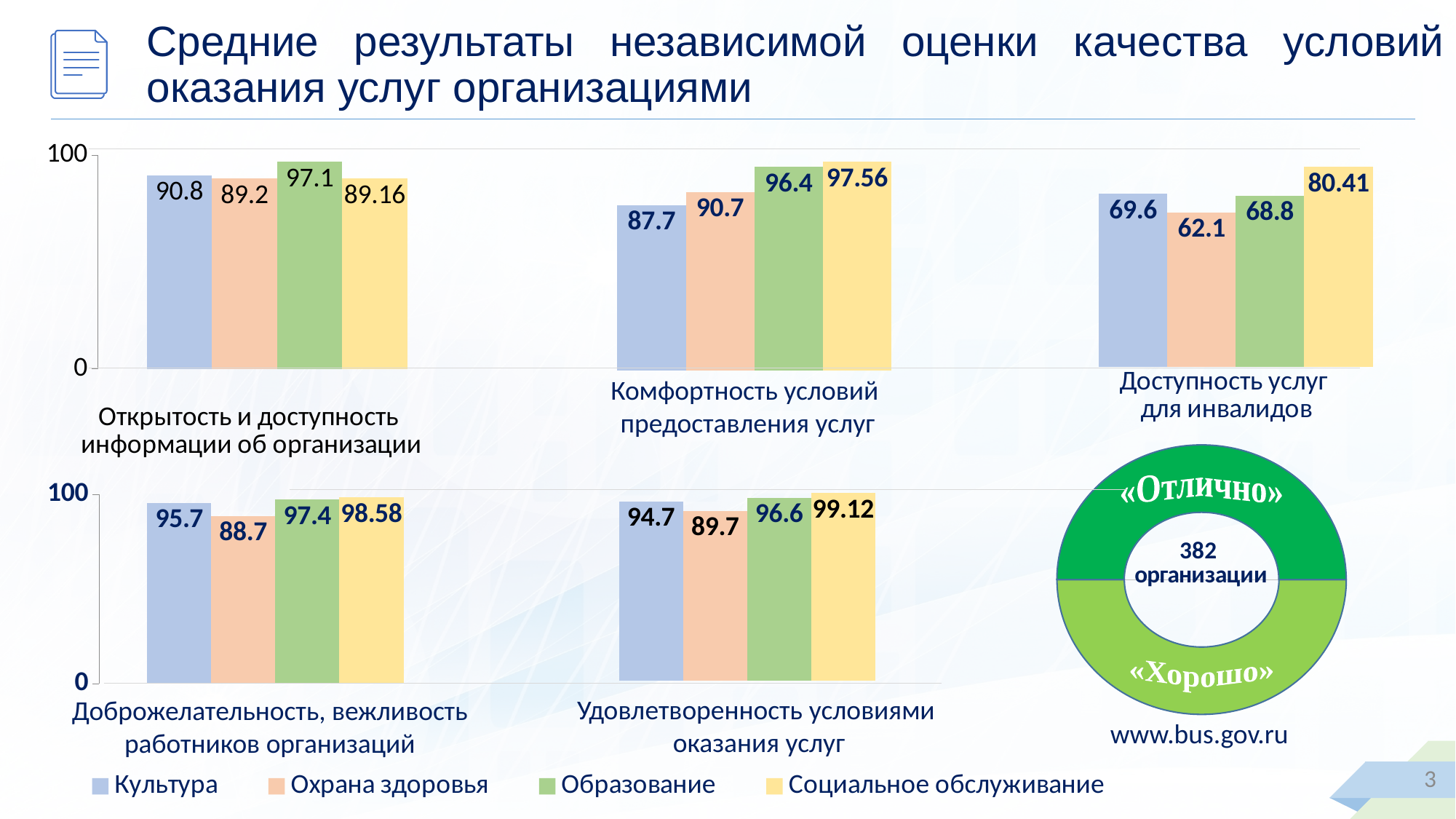
In the bar chart, what is the difference between Социальное обслуживание and Охрана здоровья under «Доброжелательность, вежливость работников организаций»? 9.88 In the bar chart, what is the value for Охрана здоровья under «Комфортность условий предоставления услуг»? 90.7 In the bar chart, which series has the highest value under «Удовлетворенность условиями оказания услуг»? Социальное обслуживание How many criteria (category groups) are shown in the bar chart? 5 In the bar chart, what is the value for Культура under «Удовлетворенность условиями оказания услуг»? 94.7 In the bar chart, which series has the lowest value under «Доступность услуг для инвалидов»? Охрана здоровья In the bar chart, how many series does the legend list? 4 In the bar chart, under «Открытость и доступность информации об организации», which is larger: Культура or Охрана здоровья? Культура What number of organisations is shown in the centre of the donut chart? 382 организации What type of chart shows the values for Культура, Охрана здоровья, Образование and Социальное обслуживание? Bar chart In the bar chart, what is the value for Образование under «Открытость и доступность информации об организации»? 97.1 In the bar chart, what is the value for Социальное обслуживание under «Доступность услуг для инвалидов»? 80.41